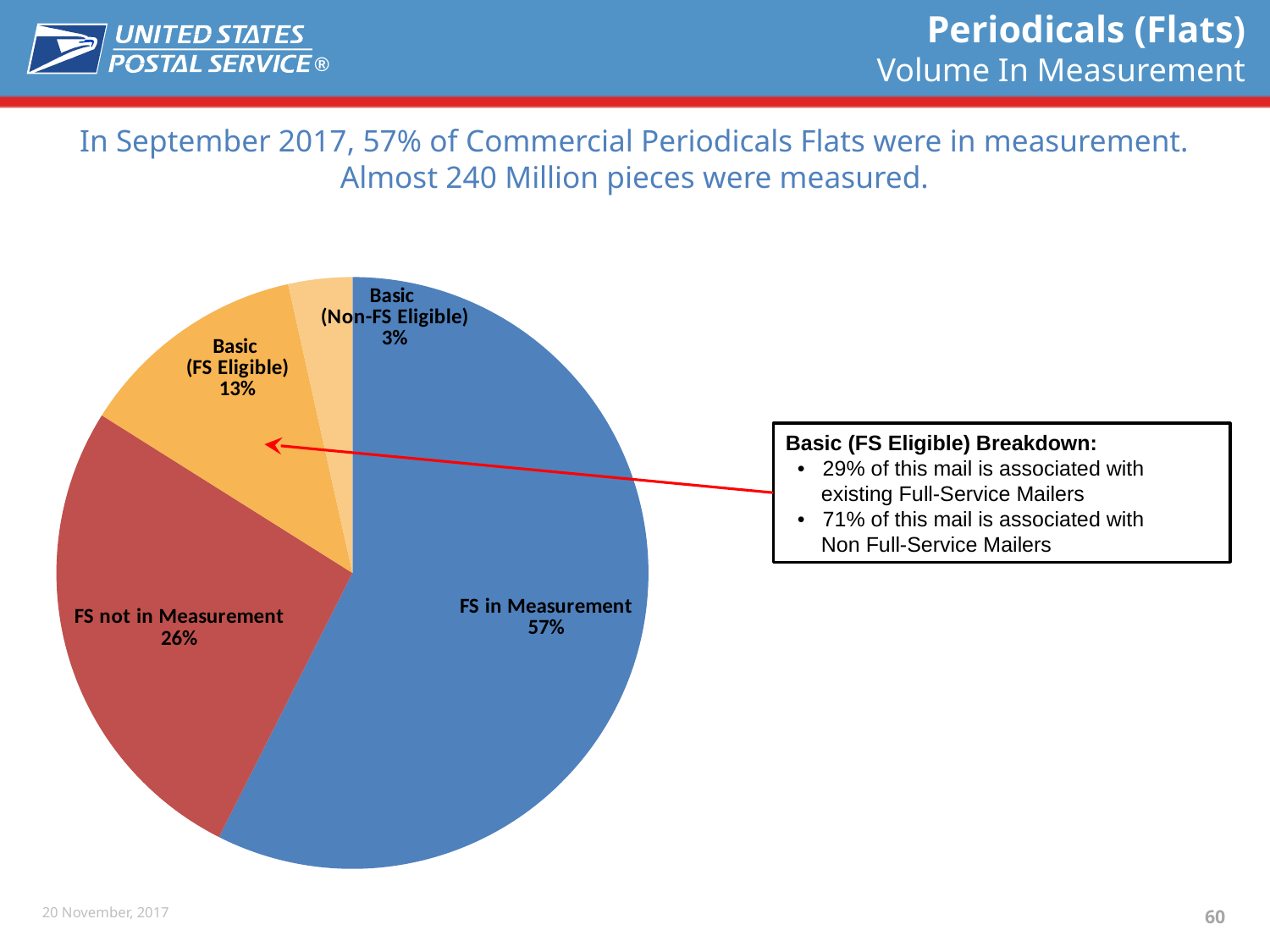
What kind of chart is shown on the slide? pie chart What is the difference in percentage points between FS in Measurement and FS not in Measurement? 31 What colour is the FS not in Measurement slice? red What share of the pie is FS in Measurement? 57% Which slice of the pie is the smallest? Basic (Non-FS Eligible) What share of the pie is Basic (FS Eligible)? 13% Which is larger, Basic (FS Eligible) or Basic (Non-FS Eligible)? Basic (FS Eligible) Which slice of the pie is the largest? FS in Measurement What share of the pie is Basic (Non-FS Eligible)? 3% How many slices does the pie chart have? 4 What is the combined share of the two Basic slices? 16%